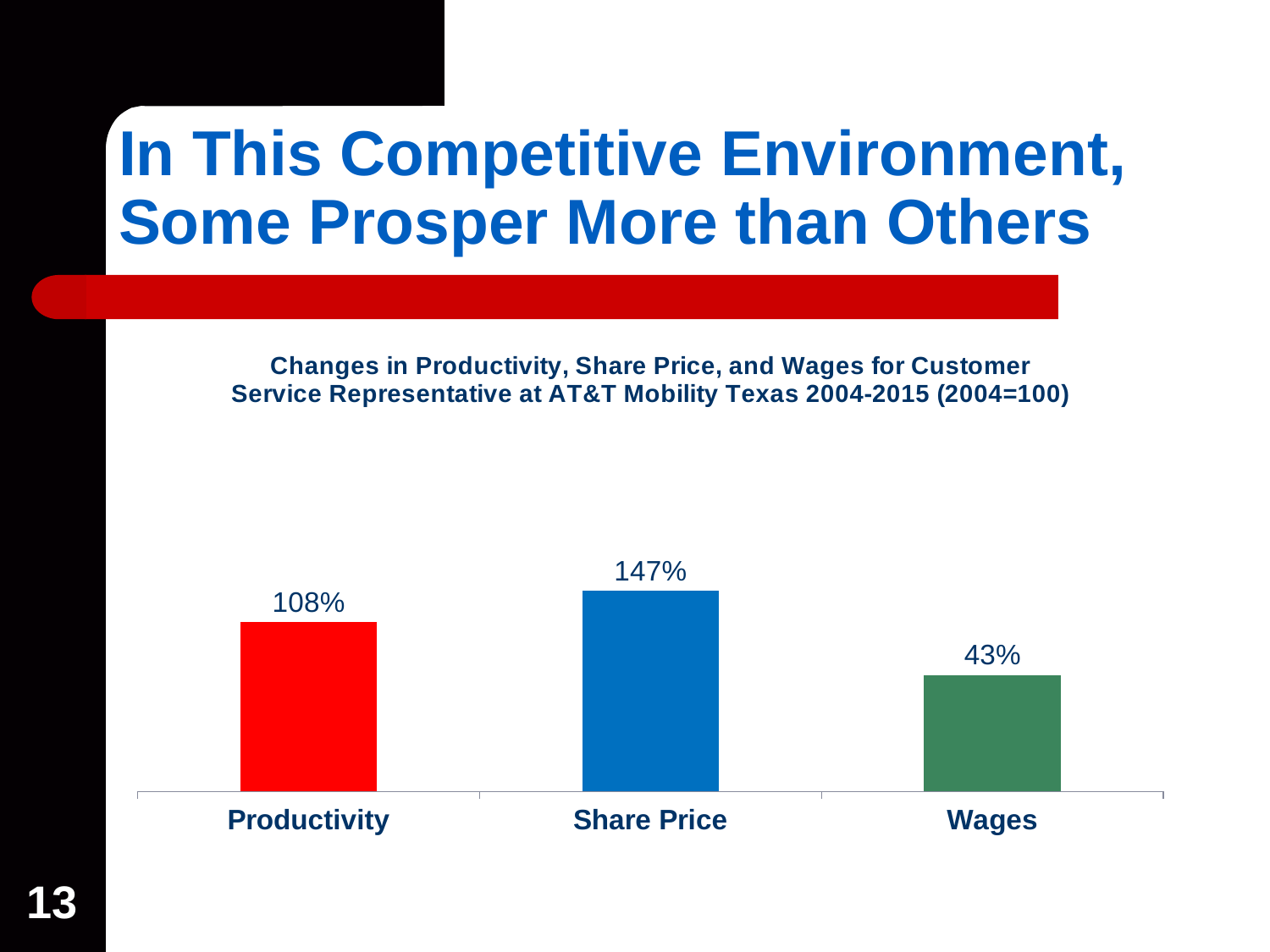
What is the difference between the Share Price value and the Wages value? 104% How many categories are shown in the chart? 3 What kind of chart is shown on the slide? Bar chart Which category has the lowest value? Wages What is the value for Wages? 43% What colour is the Share Price bar? Blue What is the value for Share Price? 147% What is the value for Productivity? 108% What is the difference between the Share Price value and the Productivity value? 39% What is the title of the chart? Changes in Productivity, Share Price, and Wages for Customer Service Representative at AT&T Mobility Texas 2004-2015 (2004=100) Which is larger, the value for Productivity or the value for Wages? Productivity Which category has the highest value? Share Price